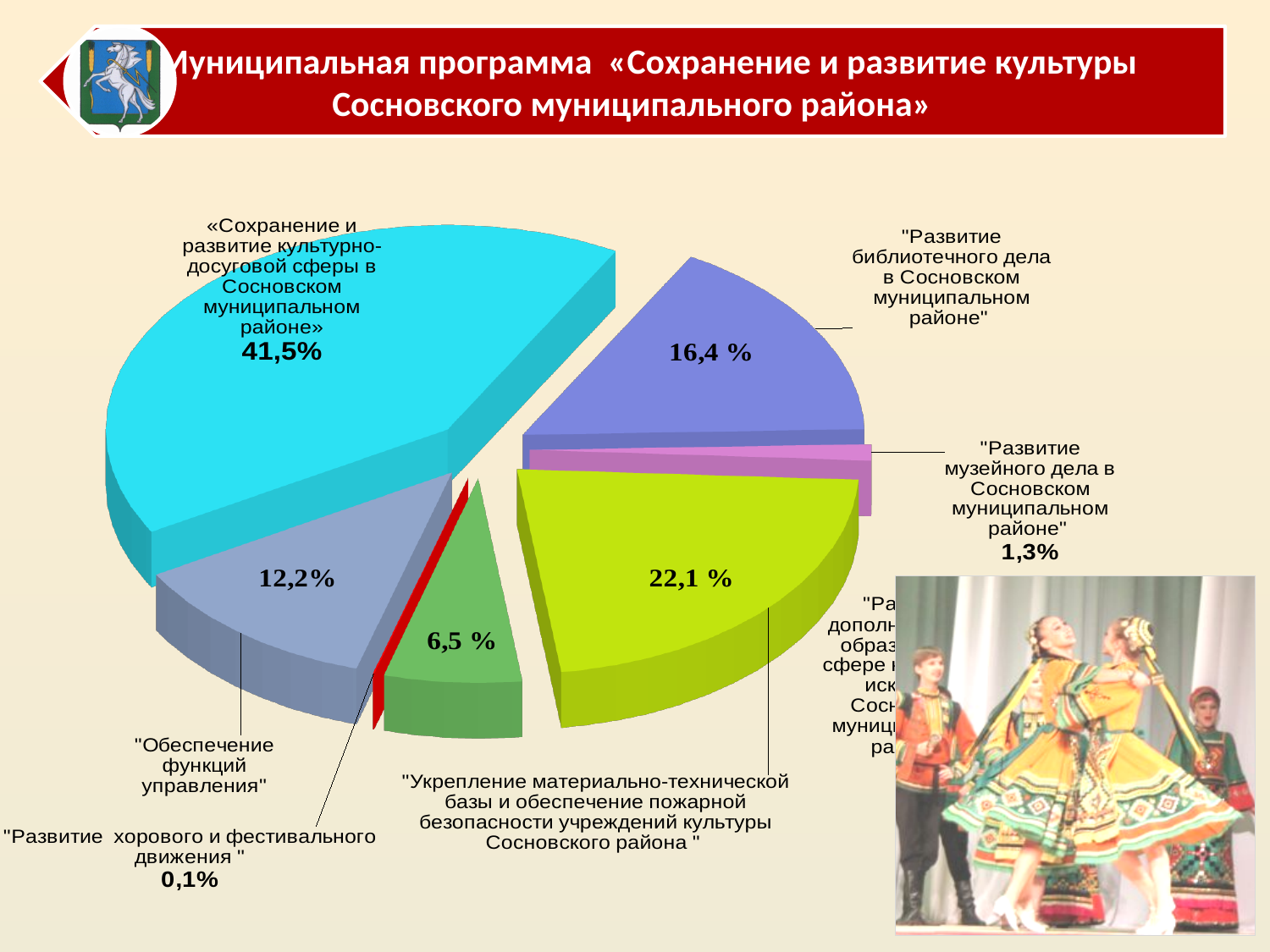
What share does the slice «Сохранение и развитие культурно-досуговой сферы в Сосновском муниципальном районе» have? 41,5% What is the difference in percentage points between the "Обеспечение функций управления" slice and the "Развитие музейного дела" slice? 10,9 How many slices does the pie chart have? 7 Which slice of the pie chart is the smallest? "Развитие хорового и фестивального движения" Which is larger: the share for "Развитие библиотечного дела" or the share for "Обеспечение функций управления"? "Развитие библиотечного дела" What is the difference in percentage points between the «Сохранение и развитие культурно-досуговой сферы» slice and the "Развитие библиотечного дела" slice? 25,1 Which slice of the pie chart is the largest? «Сохранение и развитие культурно-досуговой сферы в Сосновском муниципальном районе» What share does the slice "Развитие библиотечного дела в Сосновском муниципальном районе" have? 16,4 % What share does the slice "Развитие музейного дела в Сосновском муниципальном районе" have? 1,3% What share does the slice "Развитие хорового и фестивального движения" have? 0,1% What kind of chart is shown on the slide? pie chart What share does the slice "Обеспечение функций управления" have? 12,2%